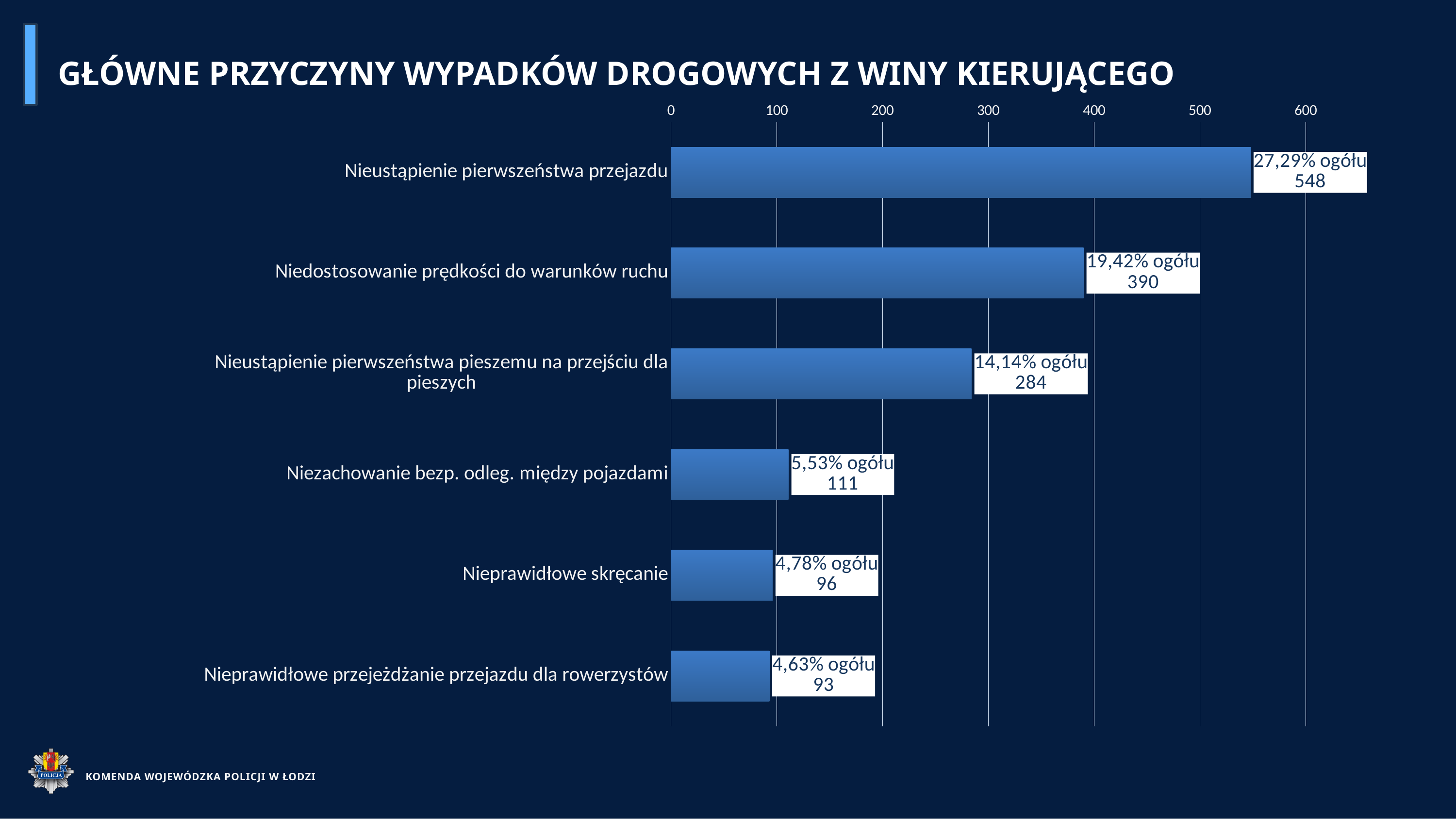
What is the value for Nieustąpienie pierwszeństwa przejazdu? 548 Which is larger: the value for Niezachowanie bezp. odleg. między pojazdami or the value for Nieprawidłowe skręcanie? Niezachowanie bezp. odleg. między pojazdami What is the title of the chart? GŁÓWNE PRZYCZYNY WYPADKÓW DROGOWYCH Z WINY KIERUJĄCEGO What kind of chart is shown on the slide? bar chart How many categories are shown in the chart? 6 What is the value for Nieprawidłowe przejeżdżanie przejazdu dla rowerzystów? 93 Which category has the lowest value? Nieprawidłowe przejeżdżanie przejazdu dla rowerzystów Is the value for Nieustąpienie pierwszeństwa pieszemu na przejściu dla pieszych greater or less than 300? less Which category has the highest value? Nieustąpienie pierwszeństwa przejazdu What is the difference between the values for Nieustąpienie pierwszeństwa przejazdu and Niedostosowanie prędkości do warunków ruchu? 158 What is the value for Niedostosowanie prędkości do warunków ruchu? 390 What percentage of the total is shown for Nieustąpienie pierwszeństwa pieszemu na przejściu dla pieszych? 14,14% ogółu